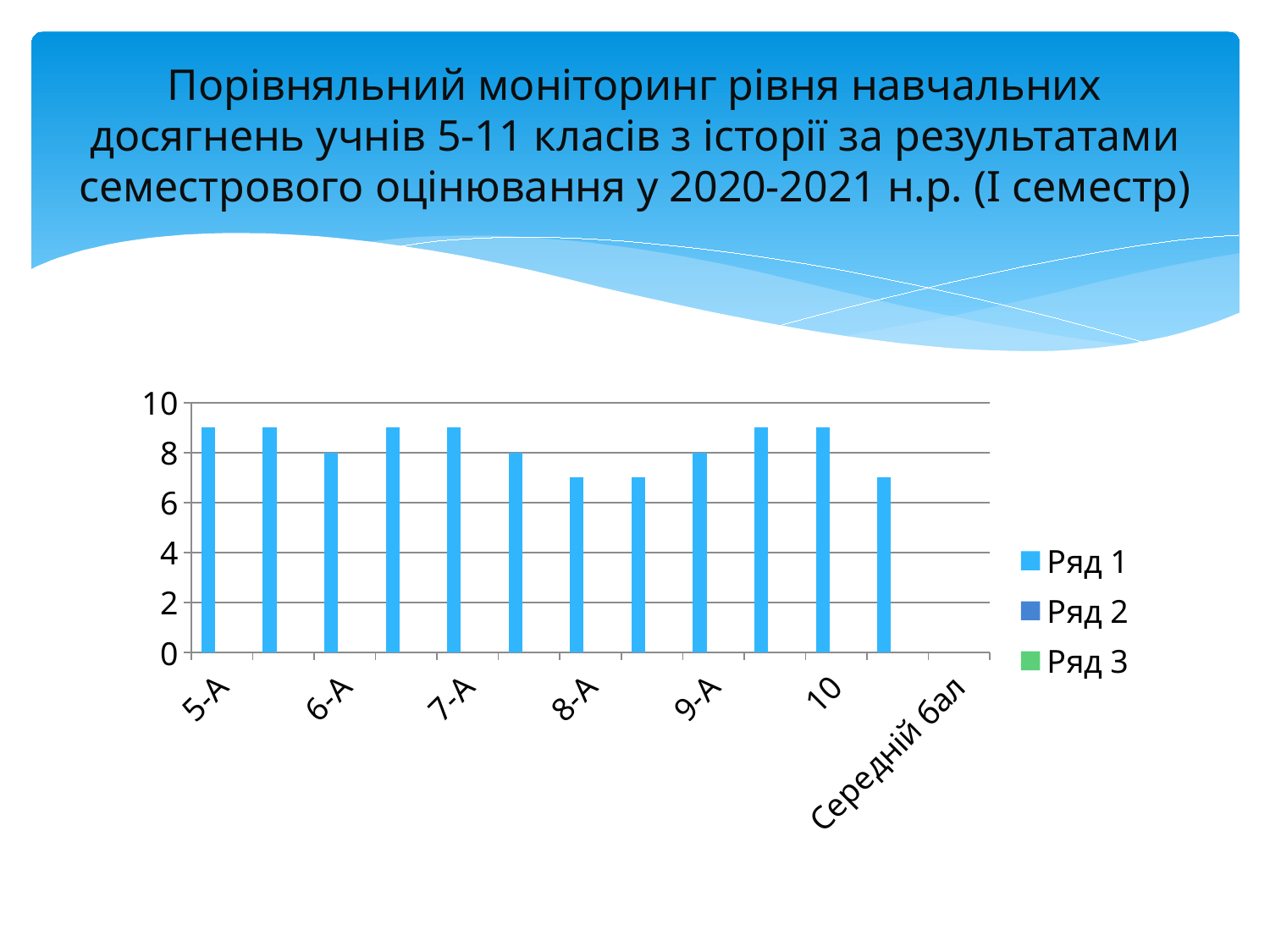
What is the value for 6-А? 8 Is the value for 10 greater or less than 8? greater What is the value for 9-А? 8 What kind of chart is shown on the slide? bar chart How many series does the legend list? 3 Among 5-А, 6-А and 8-А, which has the lowest value? 8-А How many bars are plotted in the chart? 12 What colour are the bars for Ряд 1? light blue Which is larger, the value for 5-А or the value for 8-А? 5-А Is the value for 8-А greater or less than 8? less Is the value for 5-А greater or less than 8? greater Which is larger, the value for 6-А or the value for 8-А? 6-А